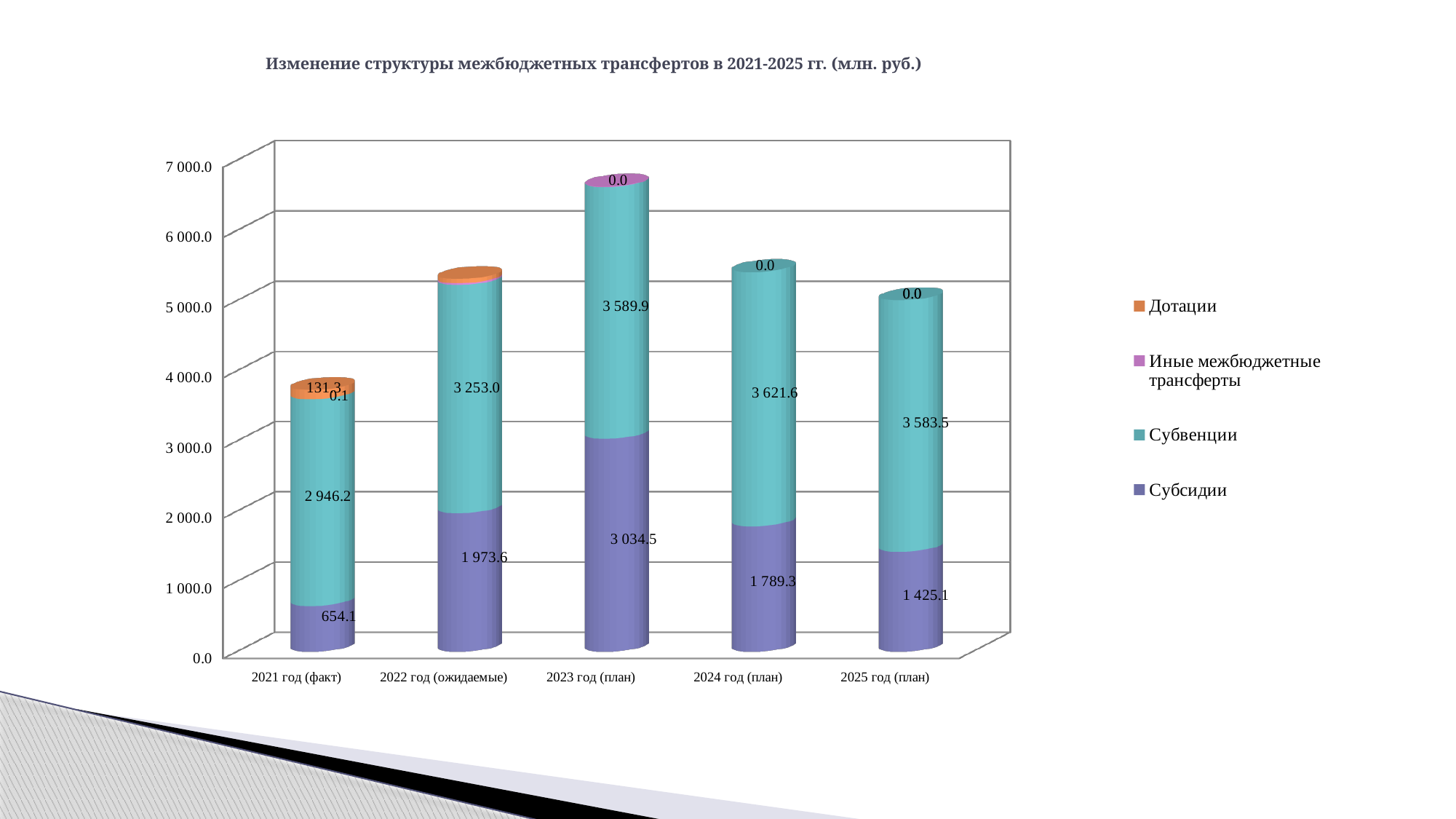
What is the value of Субвенции for 2024 год (план)? 3 621.6 How many year categories are shown on the x axis? 5 In which year is the Субсидии value the lowest? 2021 год (факт) What kind of chart is shown on the slide? stacked bar chart How many series does the legend list? 4 What is the value of Субсидии for 2021 год (факт)? 654.1 Is the total stacked value for 2023 год (план) greater or less than 6 000.0? greater What is the difference between the Субсидии values for 2023 год (план) and 2021 год (факт)? 2 380.4 What is the value of Дотации for 2021 год (факт)? 131.3 In which year is the Субсидии value the highest? 2023 год (план) Which is larger: Субвенции for 2022 год (ожидаемые) or Субвенции for 2025 год (план)? 2025 год (план) What is the total of the stacked bar for 2021 год (факт)? 3 731.7